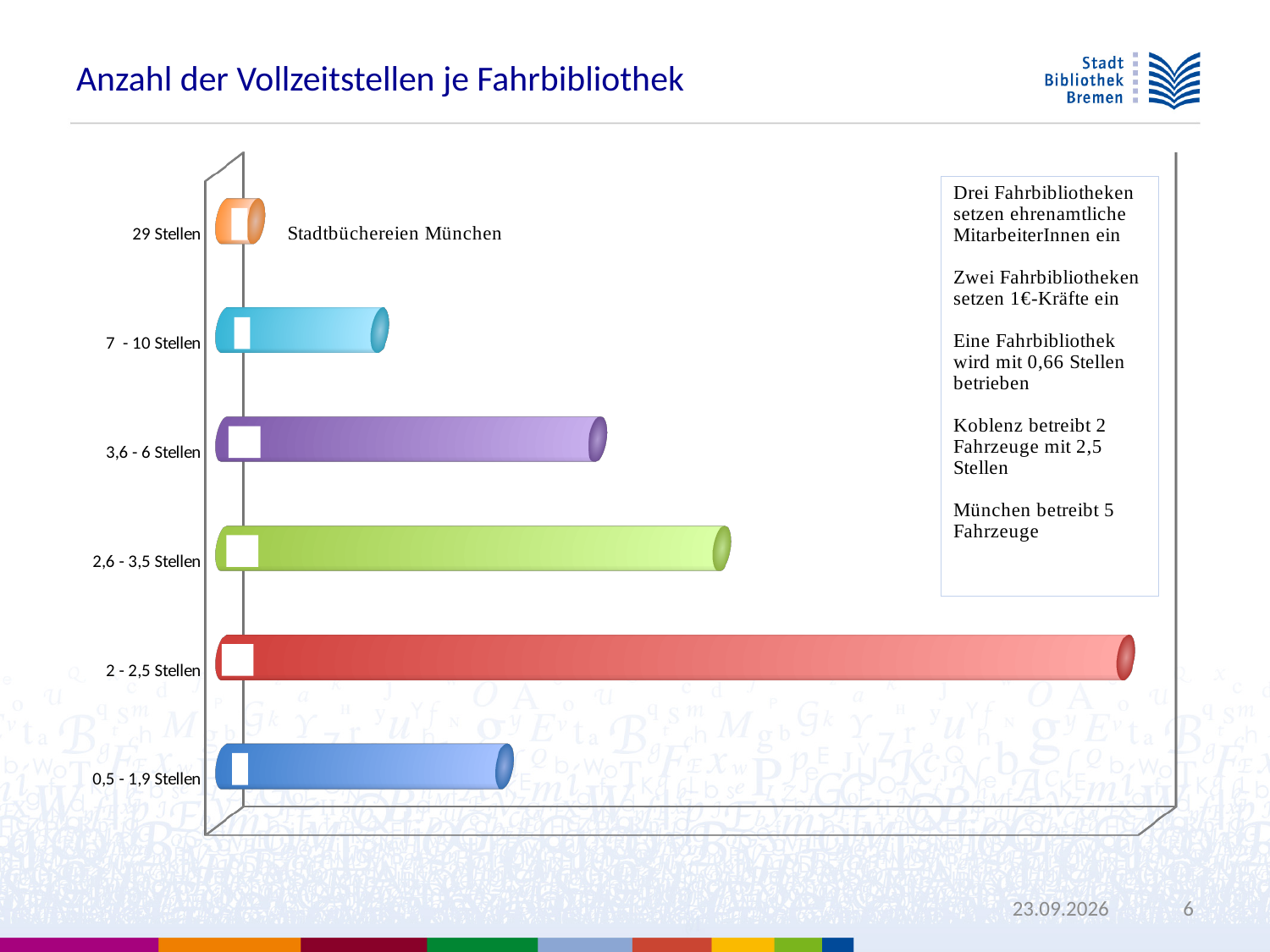
Which category has the shortest bar? 29 Stellen Which bar is longer: '2,6 - 3,5 Stellen' or '3,6 - 6 Stellen'? 2,6 - 3,5 Stellen What is the title of the chart? Anzahl der Vollzeitstellen je Fahrbibliothek Which bar is longer: '29 Stellen' or '7 - 10 Stellen'? 7 - 10 Stellen What kind of chart is shown on the slide? bar chart Which category has the second-longest bar? 2,6 - 3,5 Stellen Which bar is longer: '7 - 10 Stellen' or '0,5 - 1,9 Stellen'? 0,5 - 1,9 Stellen How many categories are plotted in the chart? 6 Which category has the longest bar? 2 - 2,5 Stellen What label is written next to the bar for '29 Stellen'? Stadtbüchereien München